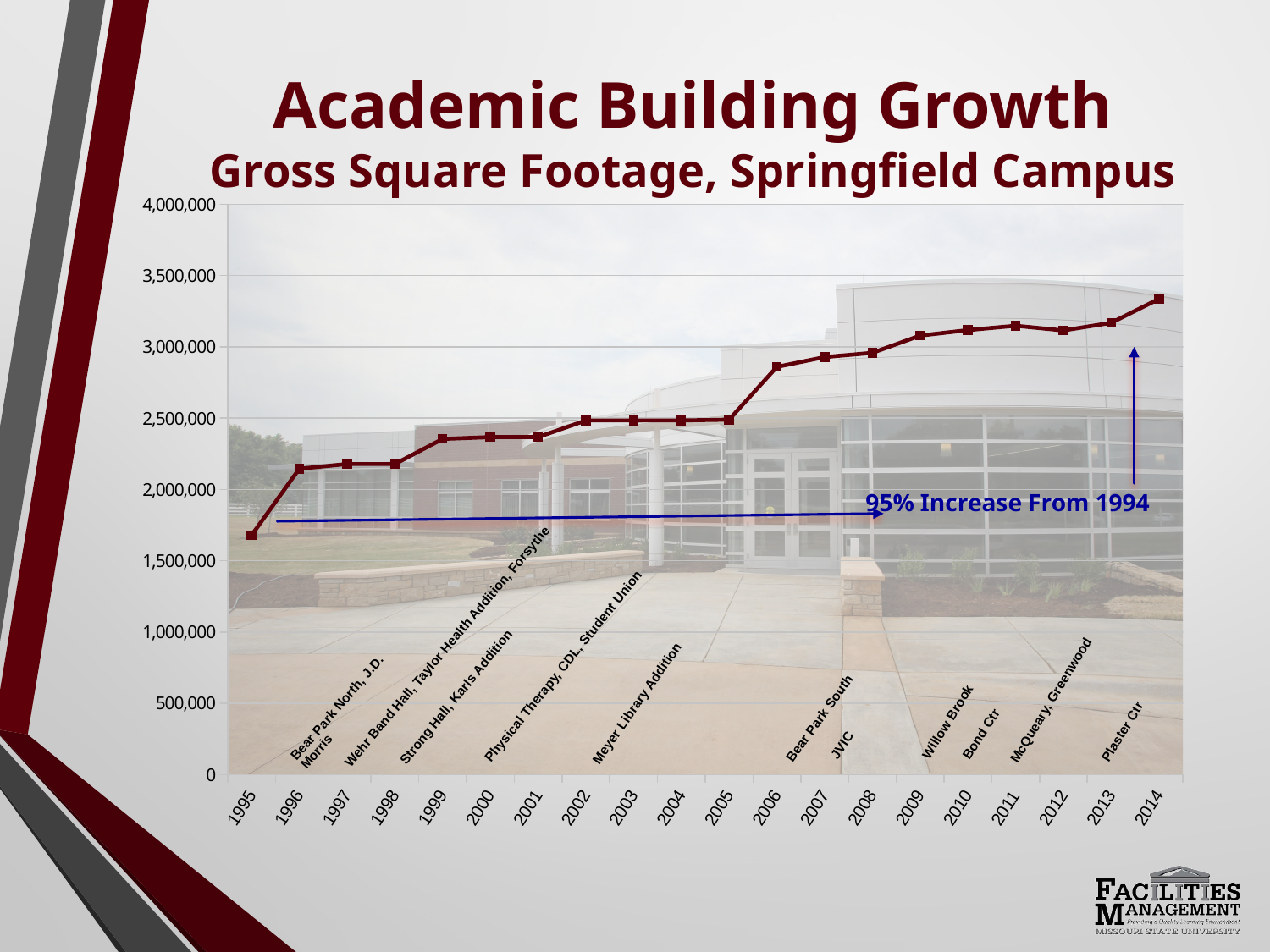
Is the value for 2006 greater or less than 2,500,000? greater Is the value for 2014 greater or less than 3,000,000? greater What percentage increase from 1994 does the annotation on the chart state? 95% Which year has the highest gross square footage? 2014 Which year has the lowest gross square footage? 1995 Is the value for 2014 greater or less than 3,500,000? less What kind of chart is shown on the slide? line chart How many years are plotted on the x axis? 20 Does the gross square footage generally rise or fall from 1995 to 2014? rise Which is larger, the value for 2006 or the value for 2001? 2006